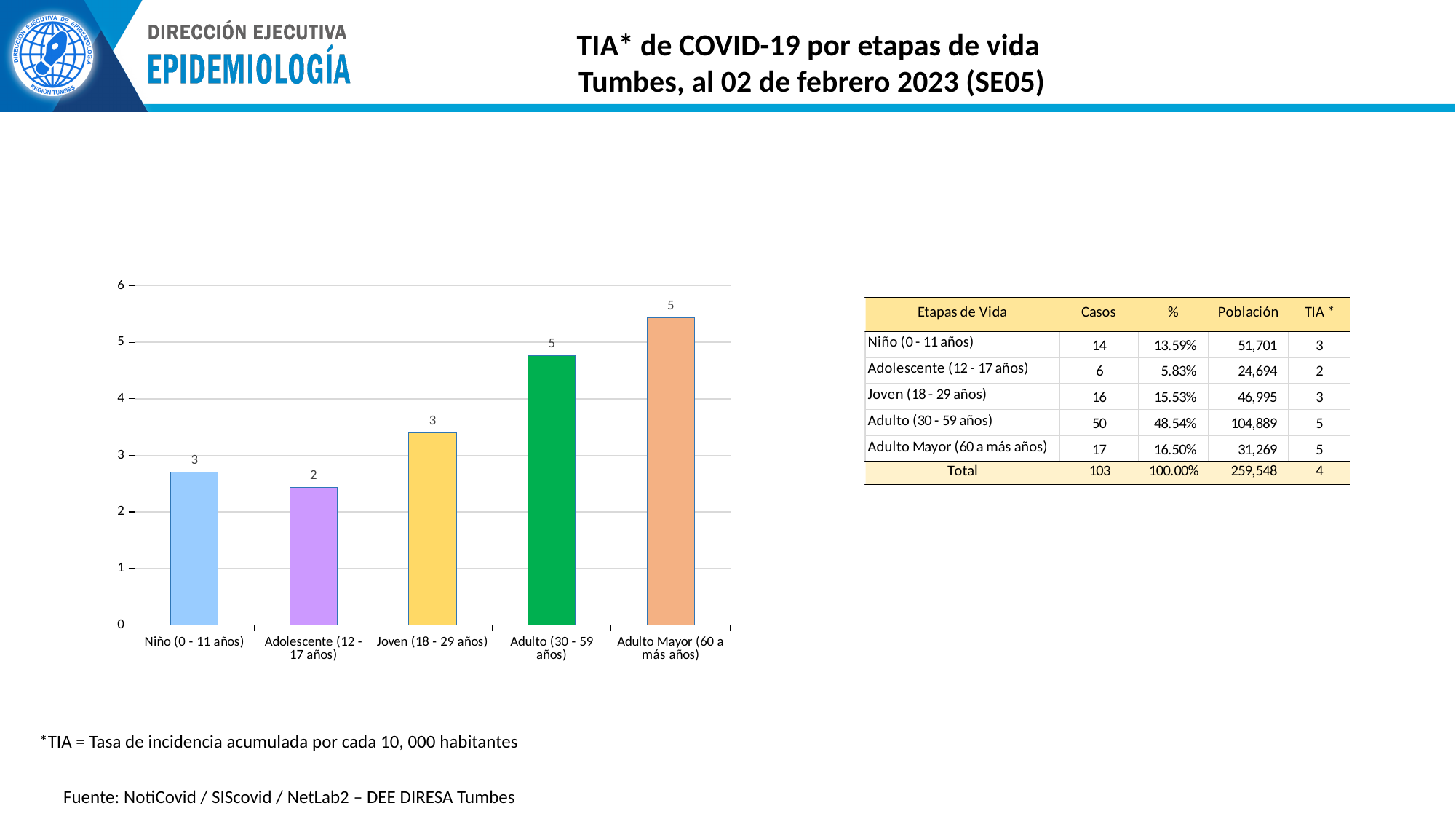
How many life-stage categories are plotted in the chart? 5 What is the TIA value shown for Adulto (30 - 59 años)? 5 Is the bar for Adulto (30 - 59 años) taller than the bar for Niño (0 - 11 años)? Yes Which life stage has the tallest bar in the chart? Adulto Mayor (60 a más años) What is the TIA value shown for Joven (18 - 29 años)? 3 Is the value for Adulto (30 - 59 años) greater or less than 4? greater What is the TIA value shown for Adolescente (12 - 17 años)? 2 What type of chart is shown on the slide? Bar chart What colour is the bar for Adulto (30 - 59 años)? Green What is the difference between the labelled values for Adulto (30 - 59 años) and Adolescente (12 - 17 años)? 3 Is the value for Adolescente (12 - 17 años) greater or less than 3? less Which life stage has the shortest bar in the chart? Adolescente (12 - 17 años)